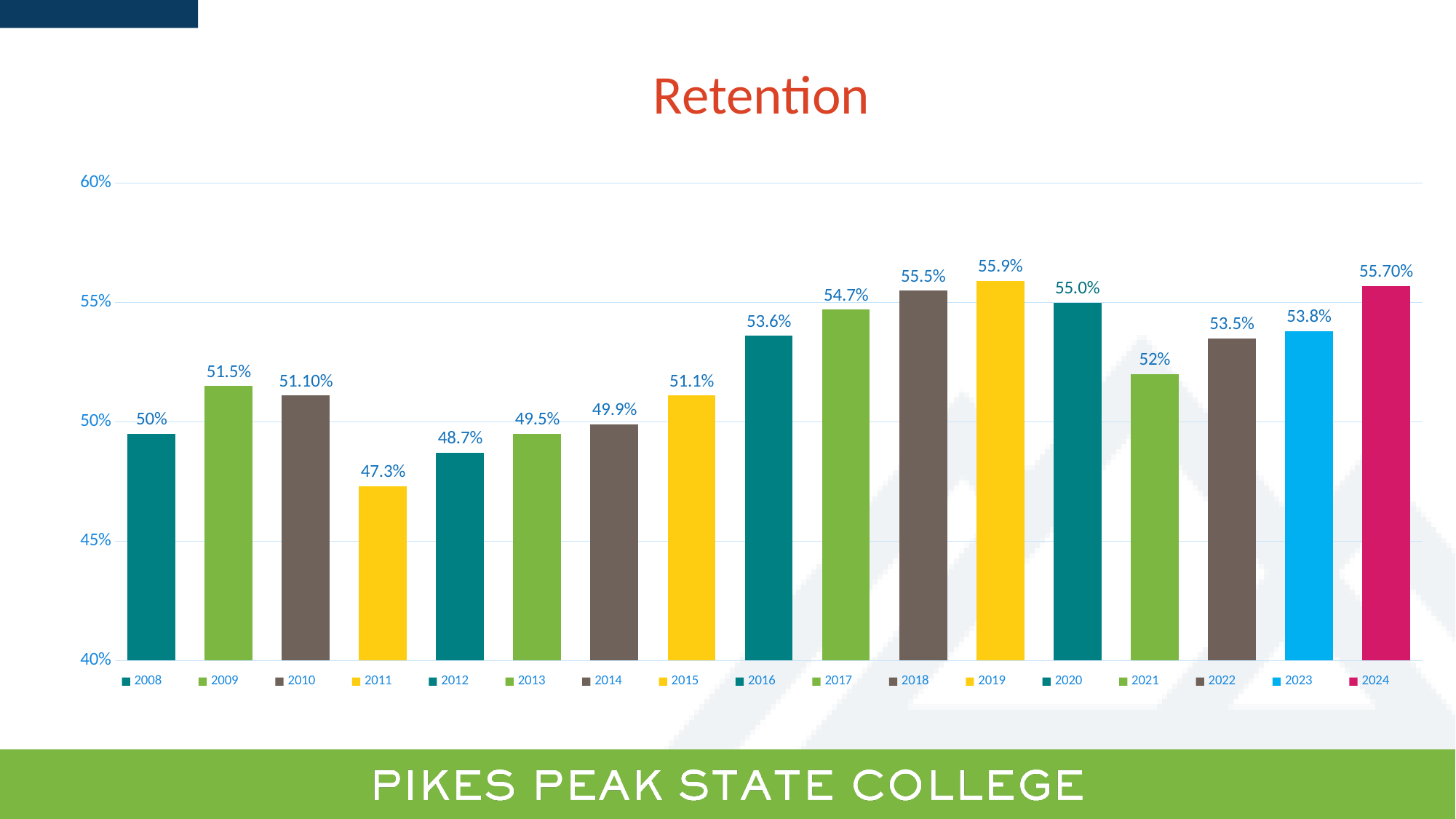
Is the retention value for 2012 greater or less than 50%? less How many entries does the legend list? 17 What is the retention value for 2011? 47.3% What is the difference between the retention values for 2019 and 2011? 8.6% Which year has the highest retention value? 2019 How many years are shown on the chart? 17 What is the title of the chart? Retention What kind of chart is shown on the slide? bar chart Which year has the lowest retention value? 2011 What is the retention value for 2016? 53.6% What is the retention value for 2024? 55.70% Which year has a larger retention value, 2018 or 2020? 2018